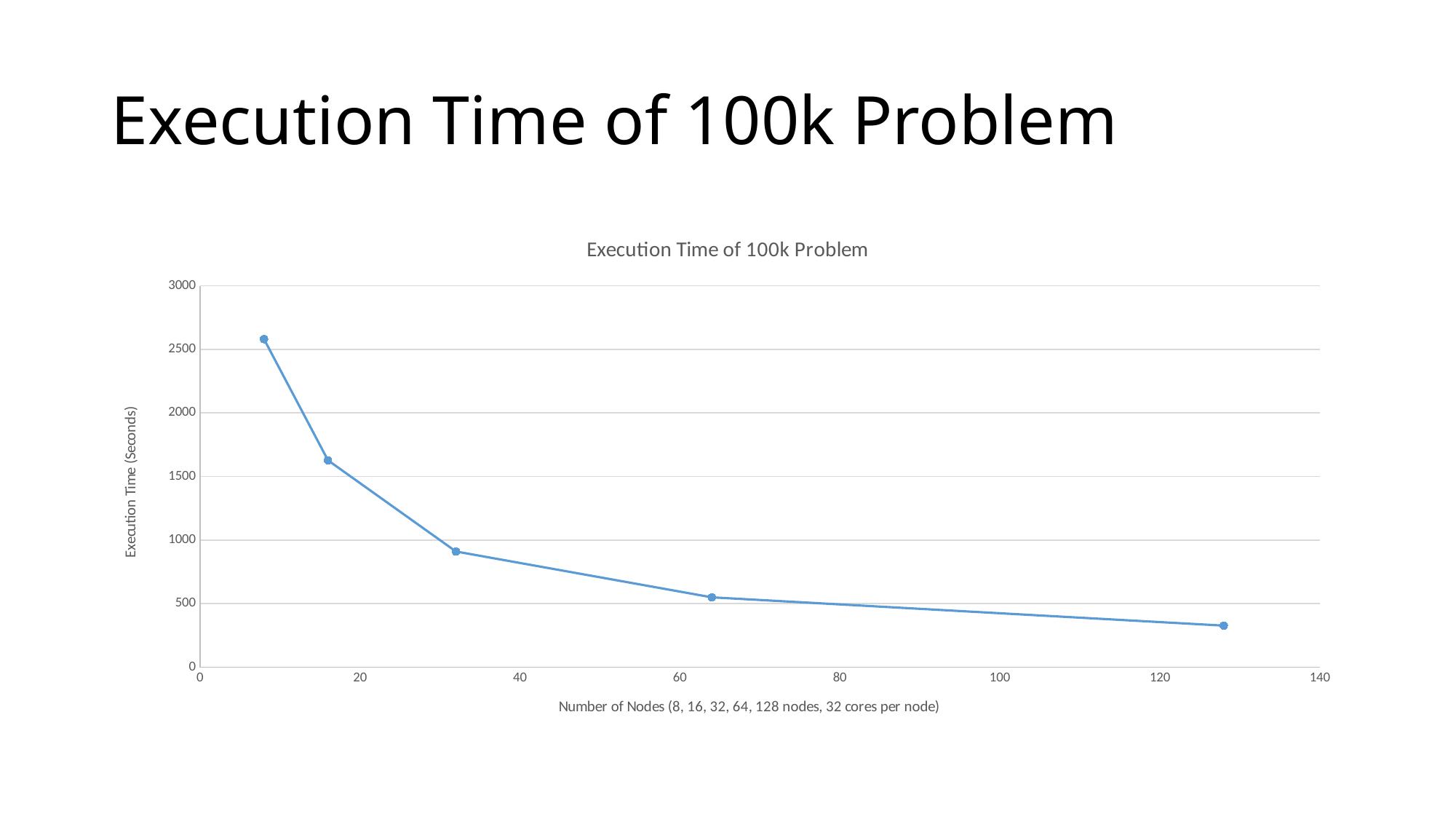
What is the label of the y axis? Execution Time (Seconds) How many data points are plotted on the chart? 5 What is the title of the chart? Execution Time of 100k Problem What kind of chart is shown on the slide? line chart Which has a higher execution time, 32 nodes or 64 nodes? 32 nodes Does the execution time rise or fall as the number of nodes increases? fall Is the execution time for 16 nodes greater or less than 1500 seconds? greater At which number of nodes is the execution time lowest? 128 Is the execution time for 128 nodes greater or less than 500 seconds? less Is the execution time for 8 nodes greater or less than 2500 seconds? greater At which number of nodes is the execution time highest? 8